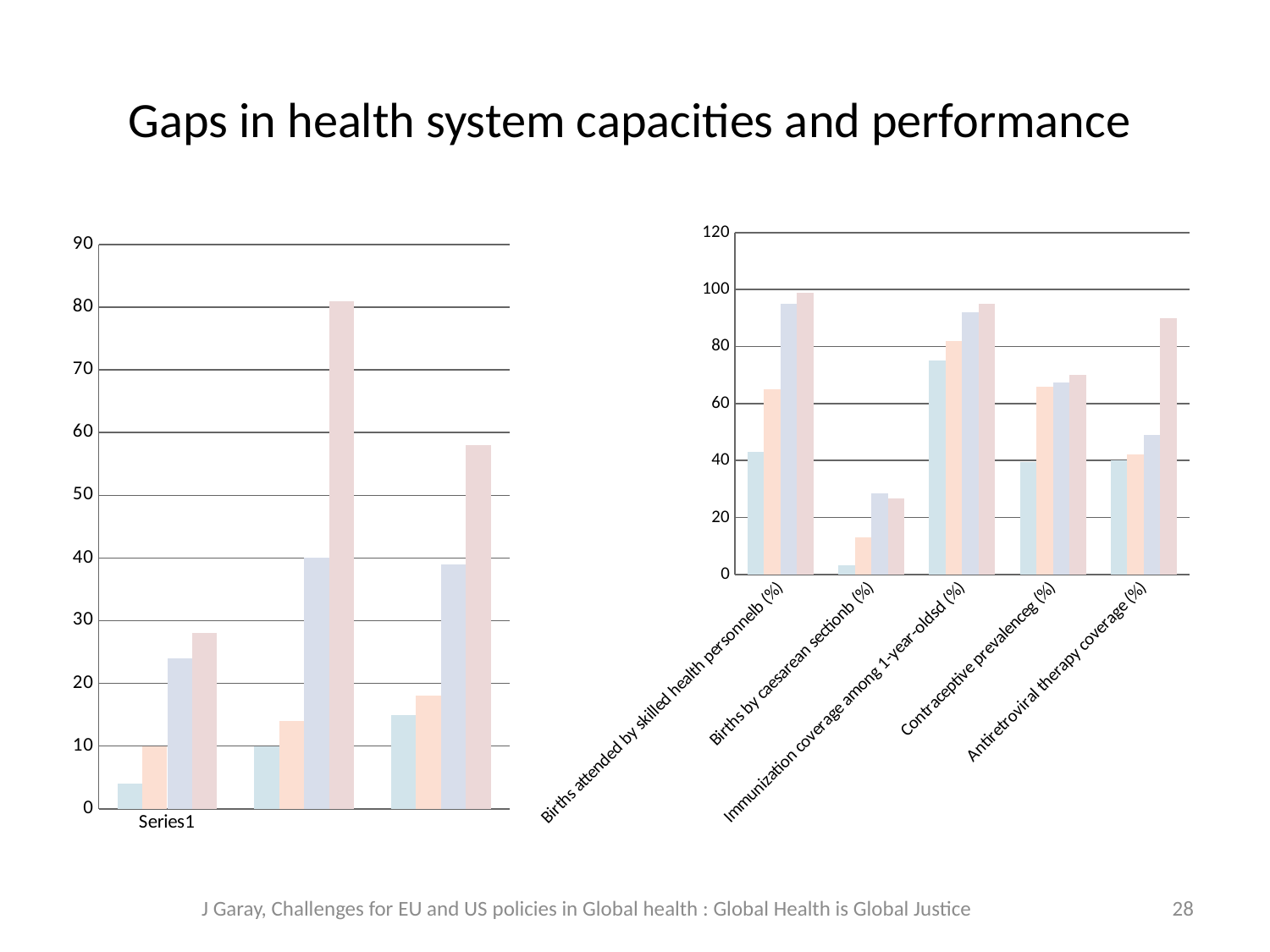
In the left chart, is the tallest bar in the Series1 group greater or less than 20? greater In the right chart, which category has the lowest bars overall? Births by caesarean sectionb (%) What kind of chart is the chart on the right of the slide? bar chart In the right chart, is the shortest bar for Births attended by skilled health personnelb (%) greater or less than 60? less In the right chart, is the tallest bar for Births by caesarean sectionb (%) greater or less than 40? less How many bars are plotted for each category in the right chart? 4 What is the highest value shown on the y axis of the right chart? 120 How many categories are shown on the x axis of the right chart? 5 In the right chart, which is larger: the tallest bar for Births by caesarean sectionb (%) or the tallest bar for Contraceptive prevalenceg (%)? Contraceptive prevalenceg (%)